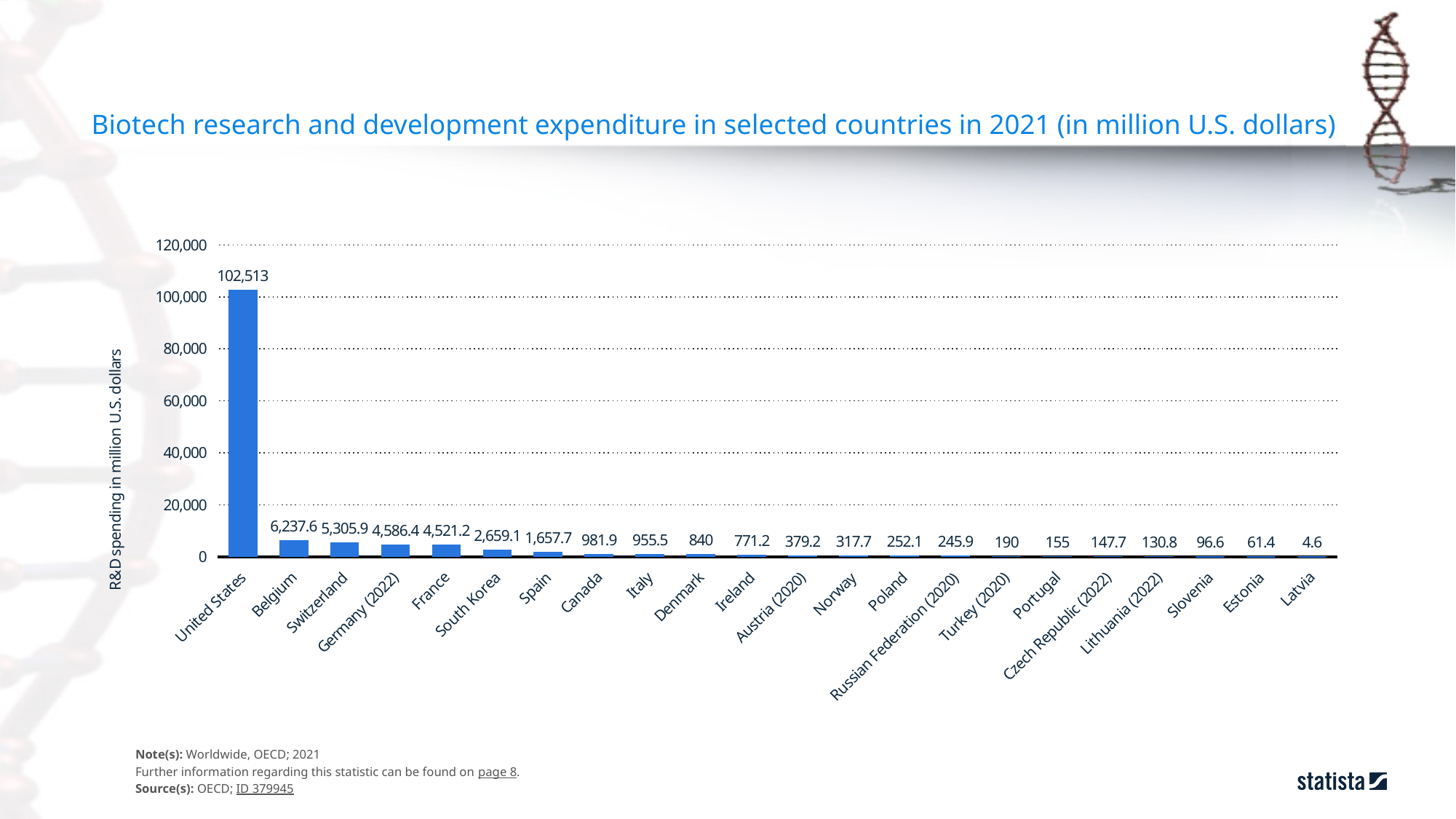
What is the difference between the biotech R&D expenditure of Belgium and Switzerland? 931.7 Is the value for the United States greater or less than 100,000? greater What is the difference between the biotech R&D expenditure of Germany (2022) and France? 65.2 What is the biotech R&D expenditure for Belgium? 6,237.6 What is the biotech R&D expenditure for Turkey (2020)? 190 What is the biotech R&D expenditure for South Korea? 2,659.1 Which country has the highest biotech R&D expenditure? United States What is the biotech R&D expenditure for the United States? 102,513 Which country has the lowest biotech R&D expenditure? Latvia How many countries are shown in the chart? 22 Which has a higher biotech R&D expenditure, Canada or Italy? Canada What type of chart is shown on the slide? Bar chart